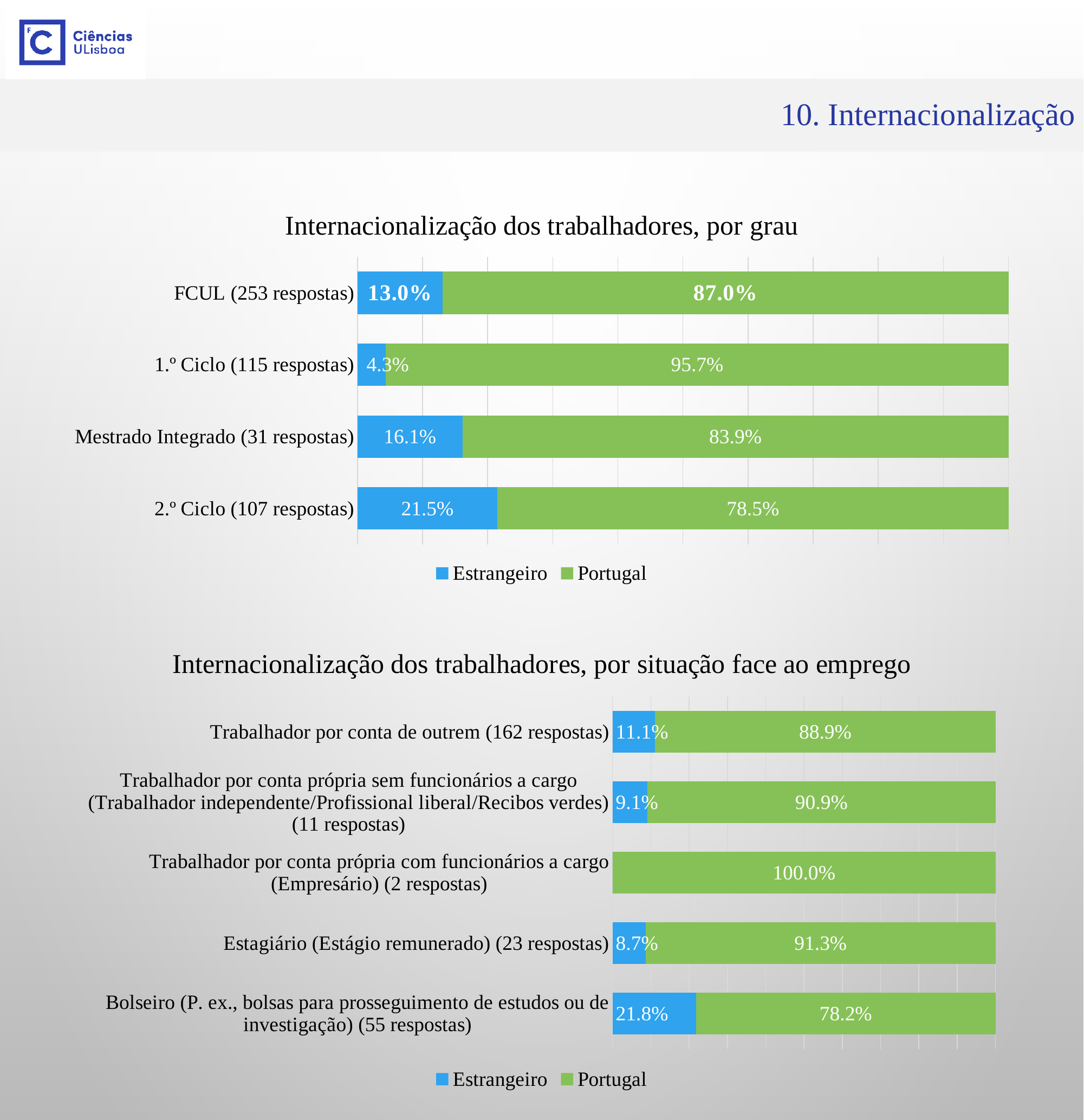
In the chart 'Internacionalização dos trabalhadores, por situação face ao emprego', is the Estrangeiro value for Estagiário (23 respostas) larger or smaller than that for Trabalhador por conta de outrem (162 respostas)? smaller In the chart 'Internacionalização dos trabalhadores, por grau', which category has the highest Estrangeiro value? 2.º Ciclo (107 respostas) In the chart 'Internacionalização dos trabalhadores, por grau', which category has the lowest Estrangeiro value? 1.º Ciclo (115 respostas) In the chart 'Internacionalização dos trabalhadores, por grau', how many categories are shown? 4 In the chart 'Internacionalização dos trabalhadores, por situação face ao emprego', which category has the highest Estrangeiro value? Bolseiro (P. ex., bolsas para prosseguimento de estudos ou de investigação) (55 respostas) In the chart 'Internacionalização dos trabalhadores, por grau', what is the difference between the Portugal values for 1.º Ciclo and 2.º Ciclo? 17.2% In the chart 'Internacionalização dos trabalhadores, por situação face ao emprego', how many series does the legend list? 2 In the chart 'Internacionalização dos trabalhadores, por situação face ao emprego', what is the Portugal value for Trabalhador por conta própria com funcionários a cargo (Empresário) (2 respostas)? 100.0% What kind of chart is 'Internacionalização dos trabalhadores, por situação face ao emprego'? Stacked bar chart In the chart 'Internacionalização dos trabalhadores, por situação face ao emprego', what is the Estrangeiro value for Bolseiro (55 respostas)? 21.8% In the chart 'Internacionalização dos trabalhadores, por grau', what is the Portugal value for 1.º Ciclo (115 respostas)? 95.7% In the chart 'Internacionalização dos trabalhadores, por grau', what is the Estrangeiro value for 2.º Ciclo (107 respostas)? 21.5%